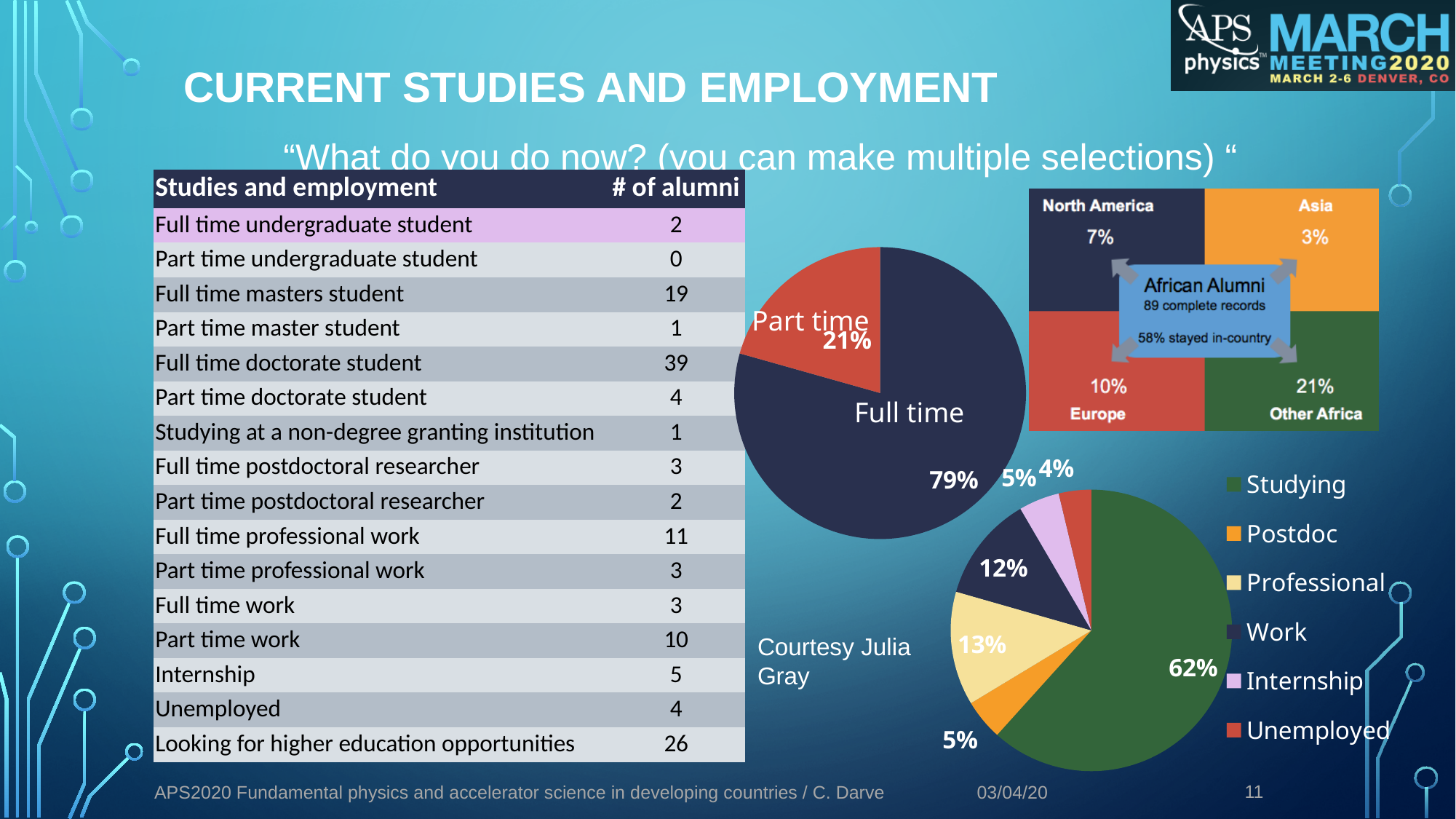
What kind of chart is the upper chart showing Full time and Part time? Pie chart In the lower-right pie chart, what share is Professional? 13% In the lower-right pie chart, what colour is the Studying slice? Green In the upper pie chart showing Full time and Part time, which slice is larger, Full time or Part time? Full time In the upper pie chart showing Full time and Part time, what share is Part time? 21% In the upper pie chart showing Full time and Part time, what is the difference in percentage points between Full time and Part time? 58 In the lower-right pie chart, what share is Work? 12% In the upper pie chart showing Full time and Part time, what share is Full time? 79% In the lower-right pie chart, what share is Studying? 62% How many categories does the legend of the lower-right pie chart list? 6 In the lower-right pie chart, which category has the largest share? Studying In the lower-right pie chart, which category has the smallest share? Unemployed